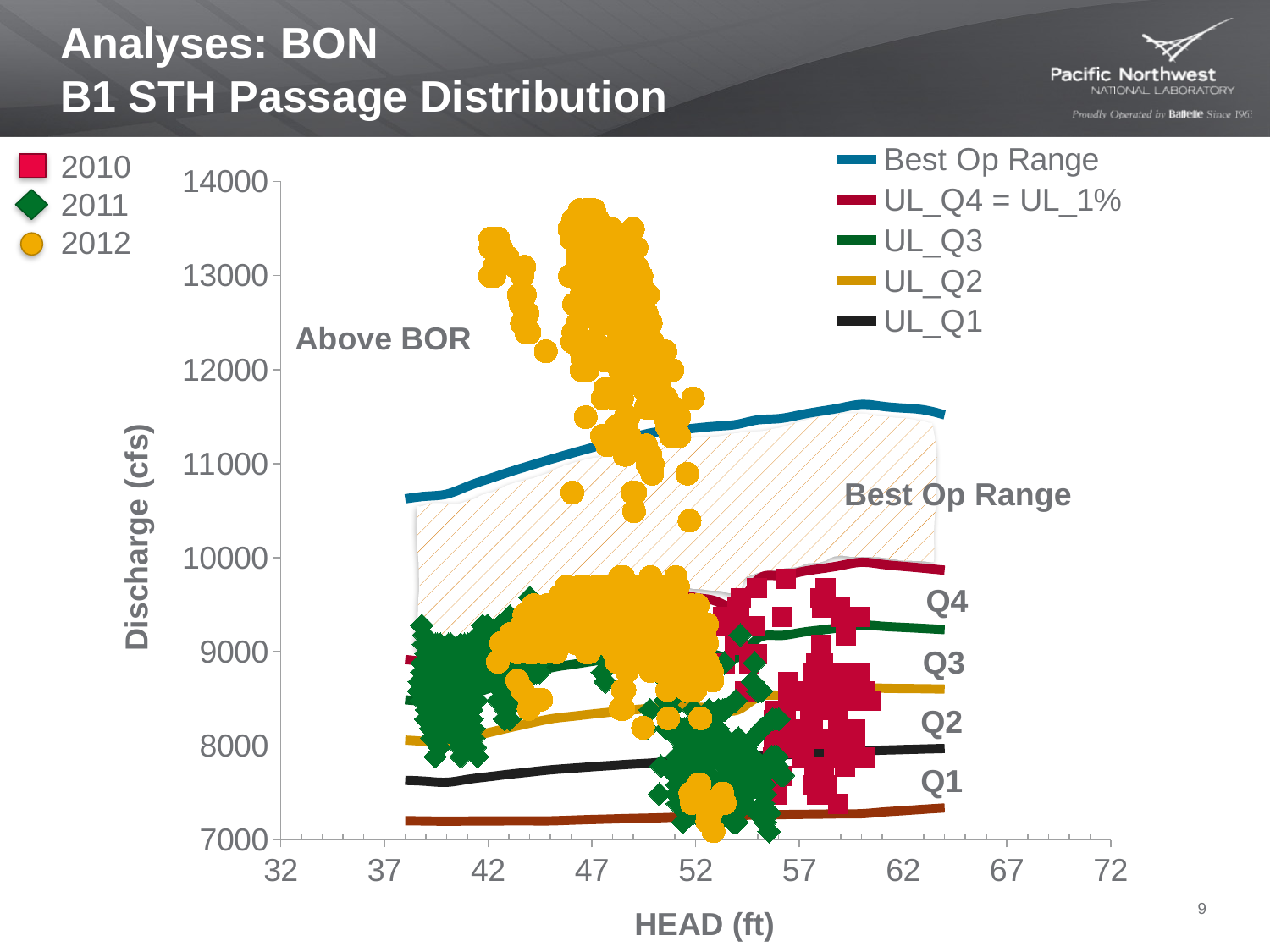
What kind of chart is shown on the slide? scatter chart Is the highest 2012 data point greater or less than 13000 cfs? greater Which line lies higher on the chart, UL_Q4 or UL_Q1? UL_Q4 What is the title of the x axis? HEAD (ft) Is the UL_Q3 line at a head of 62 ft greater or less than 9000 cfs? greater How many years does the legend on the left of the chart list? 3 Is the Best Op Range line at a head of 62 ft greater or less than 11000 cfs? greater What is the title of the y axis? Discharge (cfs) Does the Best Op Range line generally rise or fall as head increases from 37 ft to 60 ft? rise Which year is plotted with green diamond markers? 2011 How many series does the legend on the right of the chart list? 5